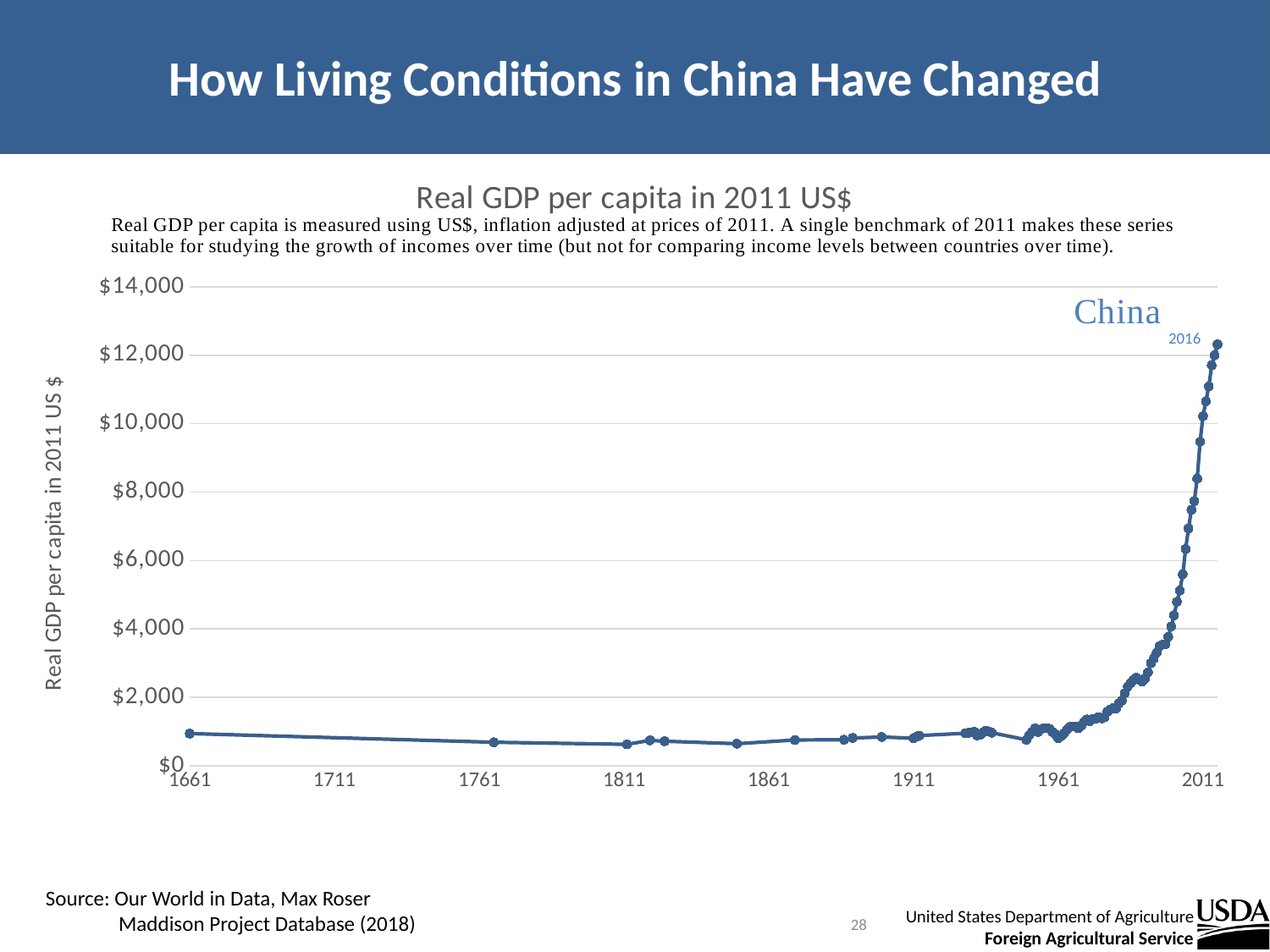
Is the value for 2011 greater or less than $8,000? greater Is the value for 1661 greater or less than $2,000? less What is the title of the chart? Real GDP per capita in 2011 US$ Which year is labeled at the end of the line as the latest data point? 2016 Is the value for 2016 greater or less than $10,000? greater Which country does the plotted line represent? China Which is larger, the value for 2016 or the value for 1911? 2016 What kind of chart is shown on the slide? line chart In which year does China's real GDP per capita reach its highest value on the chart? 2016 How many data series are plotted on the chart? 1 Overall, does China's real GDP per capita rise or fall from 1961 to 2016? rise